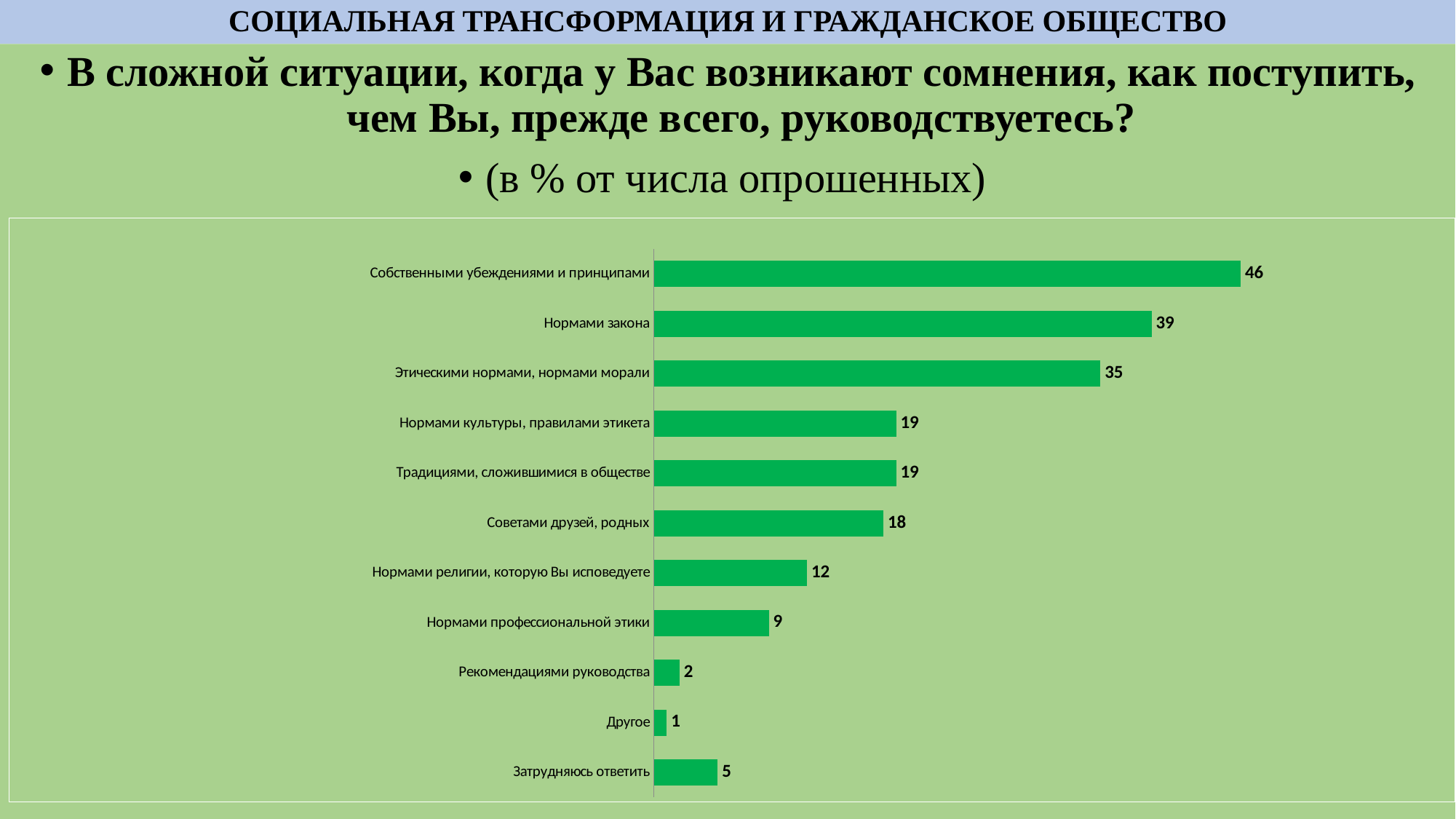
What is the difference between the values for «Нормами закона» and «Этическими нормами, нормами морали»? 4 Which is larger: the value for «Советами друзей, родных» or the value for «Нормами профессиональной этики»? Советами друзей, родных Which category has the highest value? Собственными убеждениями и принципами How many categories are shown in the chart? 11 What is the value for «Собственными убеждениями и принципами»? 46 What is the value for «Нормами закона»? 39 What kind of chart is shown on the slide? Bar chart Which category has the lowest value? Другое What is the difference between the values for «Собственными убеждениями и принципами» and «Рекомендациями руководства»? 44 What colour are the bars in the chart? Green What is the value for «Затрудняюсь ответить»? 5 What is the value for «Нормами религии, которую Вы исповедуете»? 12